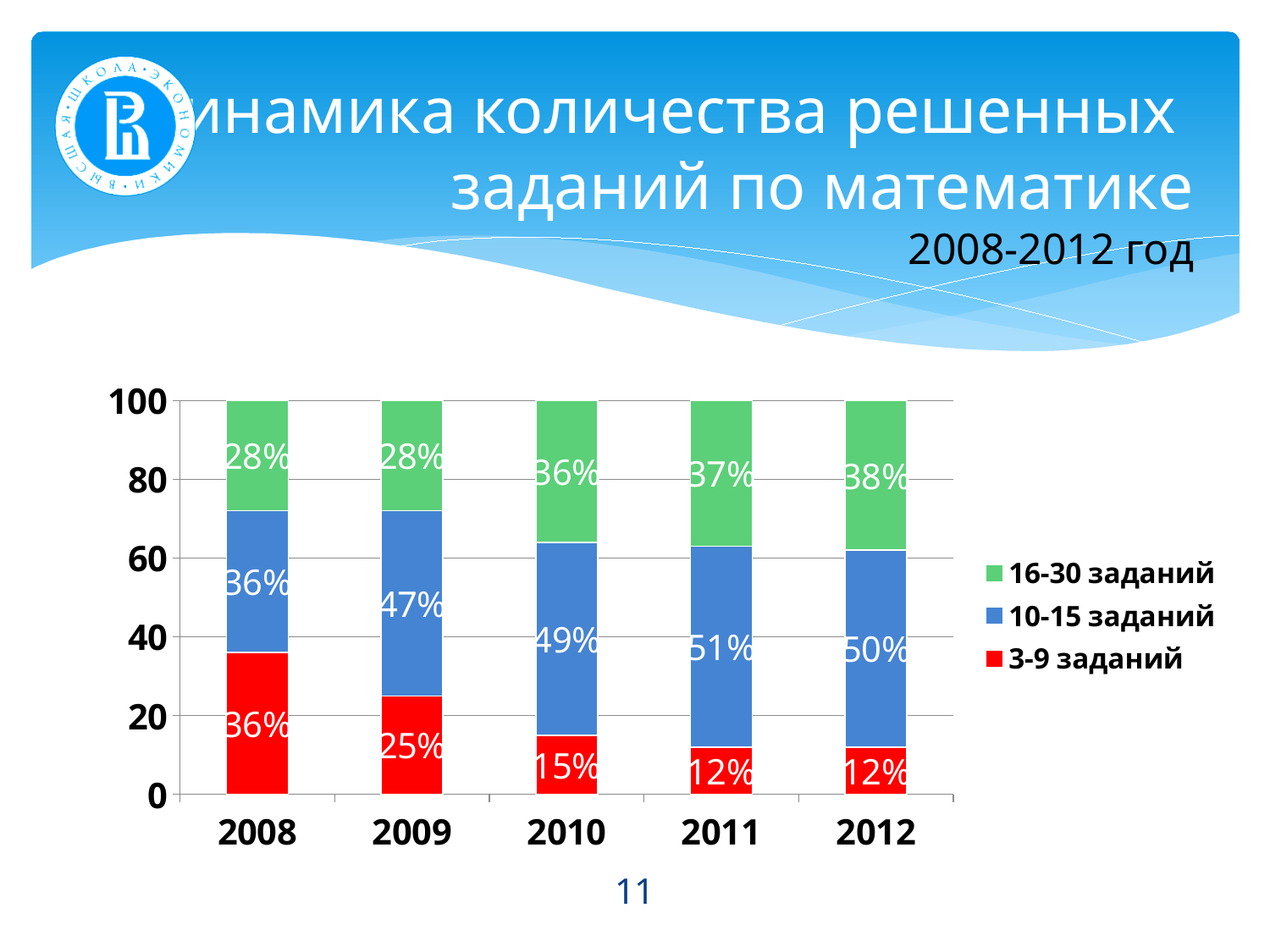
What is the difference between the "3-9 заданий" values in 2008 and 2012? 24% What is the value for "10-15 заданий" in 2009? 47% What is the value for "3-9 заданий" in 2008? 36% What kind of chart is shown on the slide? Stacked bar chart In which year is the value for "16-30 заданий" lowest? 2008 and 2009 How many series does the legend list? 3 Which is larger: the "10-15 заданий" value in 2010 or in 2011? 2011 Does the value for "3-9 заданий" rise or fall from 2008 to 2012? Fall How many years are shown on the x axis? 5 Which colour represents "16-30 заданий" in the legend? Green What is the value for "16-30 заданий" in 2012? 38% In which year is the value for "3-9 заданий" highest? 2008